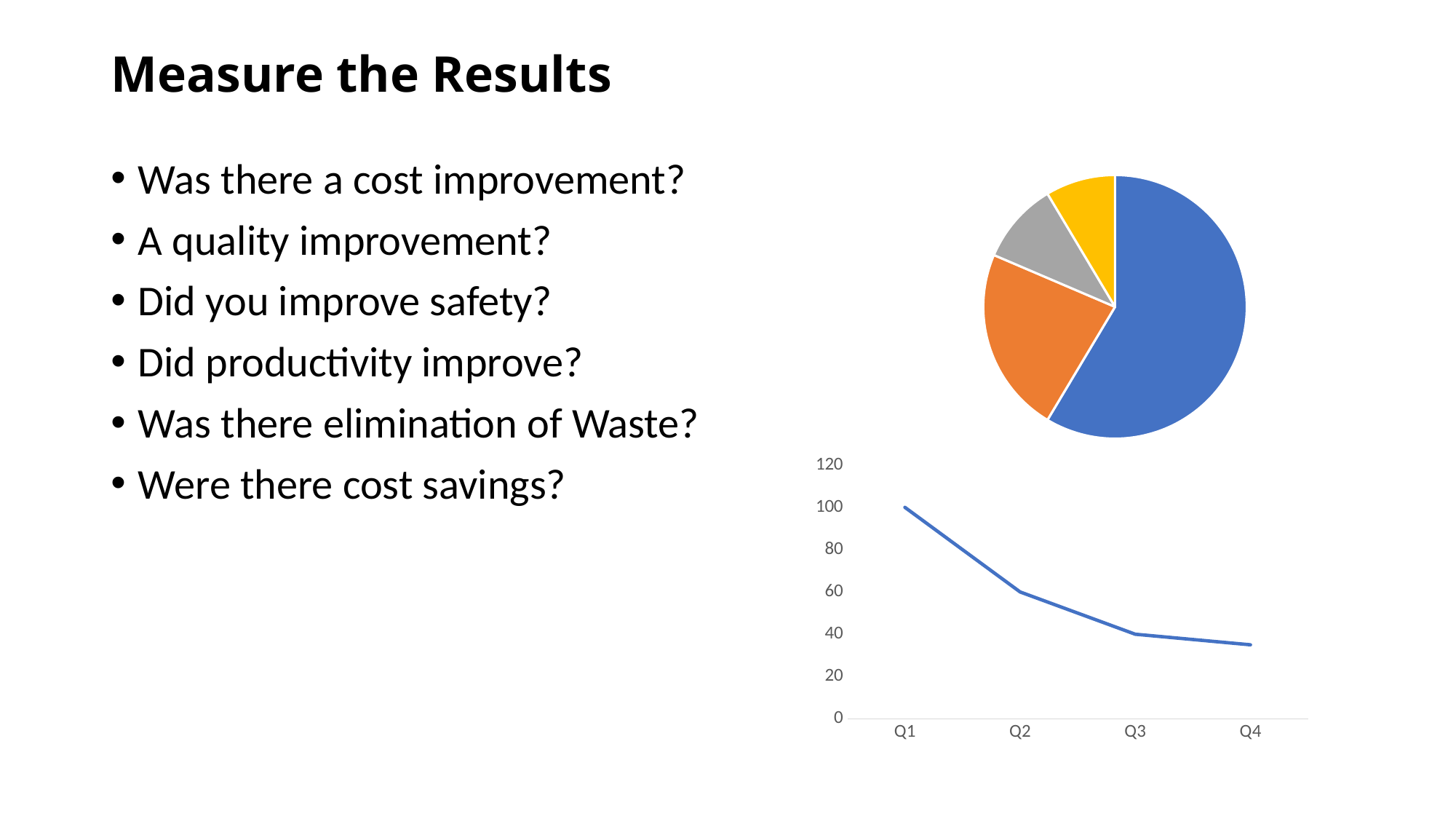
In the line chart at the bottom right, how many points are plotted along the x axis? 4 In the line chart at the bottom right, is the value for Q3 greater or less than 60? less In the line chart at the bottom right, is the value for Q2 greater or less than 40? greater What kind of chart is the chart at the bottom right of the slide? line chart In the line chart at the bottom right, which quarter has the lowest value? Q4 In the line chart at the bottom right, what is the value for Q1? 100 In the line chart at the bottom right, which quarter has the highest value? Q1 In the line chart at the bottom right, do the values rise or fall from Q1 to Q4? fall What kind of chart is the chart at the top right of the slide? pie chart In the pie chart at the top right, what colour is the largest slice? blue In the pie chart at the top right, how many slices are there? 4 In the line chart at the bottom right, which is larger, the value for Q1 or the value for Q3? Q1